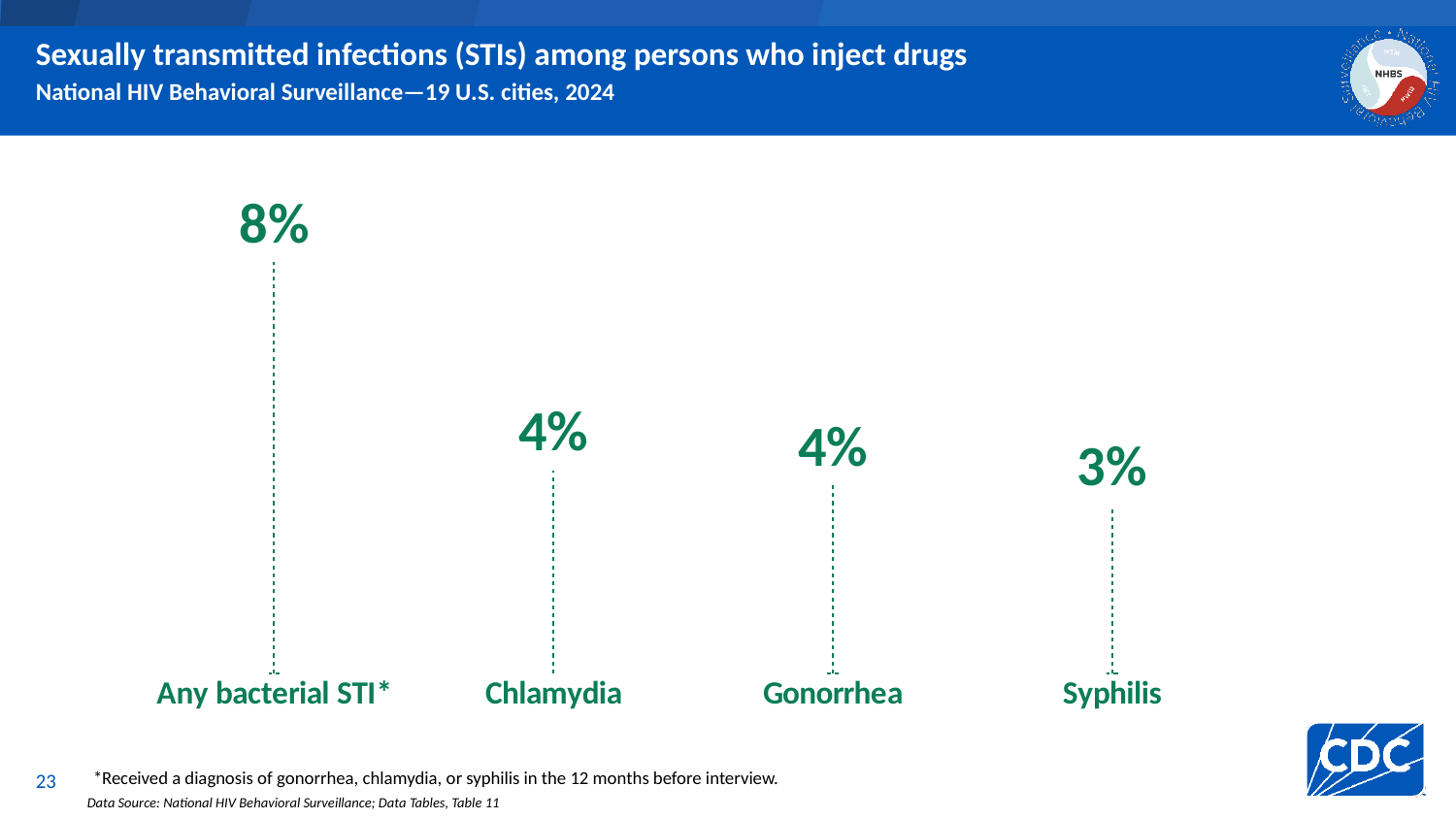
What is the difference between the values for Any bacterial STI* and Syphilis? 5 percentage points Which is larger, the value for Gonorrhea or the value for Syphilis? Gonorrhea What is the value for Syphilis? 3% What is the value for Chlamydia? 4% What is the difference between the values for Any bacterial STI* and Chlamydia? 4 percentage points What is the value for Any bacterial STI*? 8% What is the title of the chart? Sexually transmitted infections (STIs) among persons who inject drugs Do the values rise or fall from left to right across the categories? fall Which category has the lowest value? Syphilis Which category has the highest value? Any bacterial STI* What is the value for Gonorrhea? 4% How many categories are shown in the chart? 4